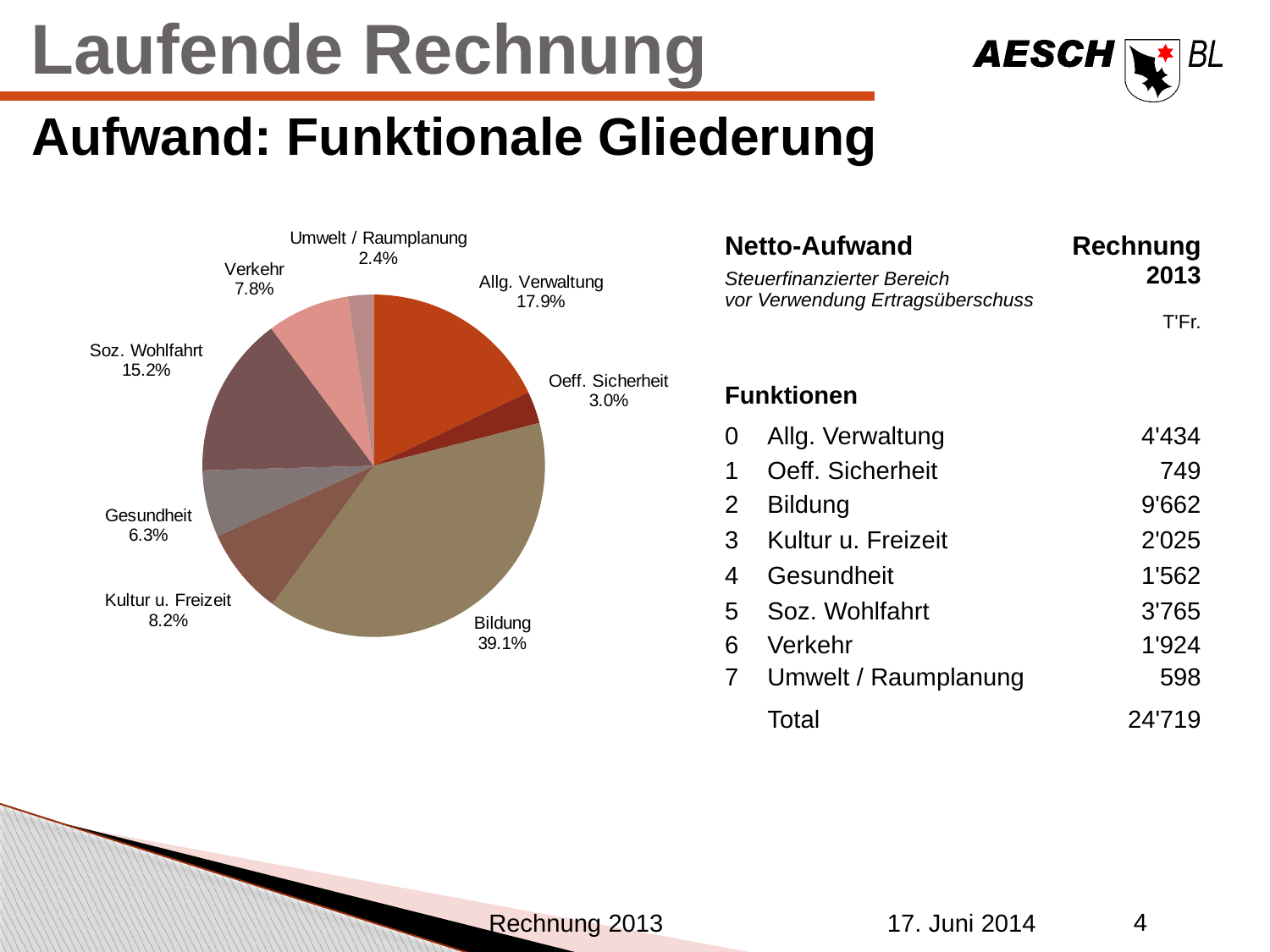
What share of the pie does Soz. Wohlfahrt have? 15.2% What share of the pie does Umwelt / Raumplanung have? 2.4% What share of the pie does Bildung have? 39.1% Which slice is larger, Verkehr or Kultur u. Freizeit? Kultur u. Freizeit Which slice of the pie chart is the largest? Bildung What is the difference in percentage points between the Soz. Wohlfahrt slice and the Gesundheit slice? 8.9% Which slice of the pie chart is the smallest? Umwelt / Raumplanung How many slices does the pie chart have? 8 What is the difference in percentage points between the Bildung slice and the Allg. Verwaltung slice? 21.2% What kind of chart is shown on the slide? pie chart What is the heading above the pie chart on the slide? Aufwand: Funktionale Gliederung